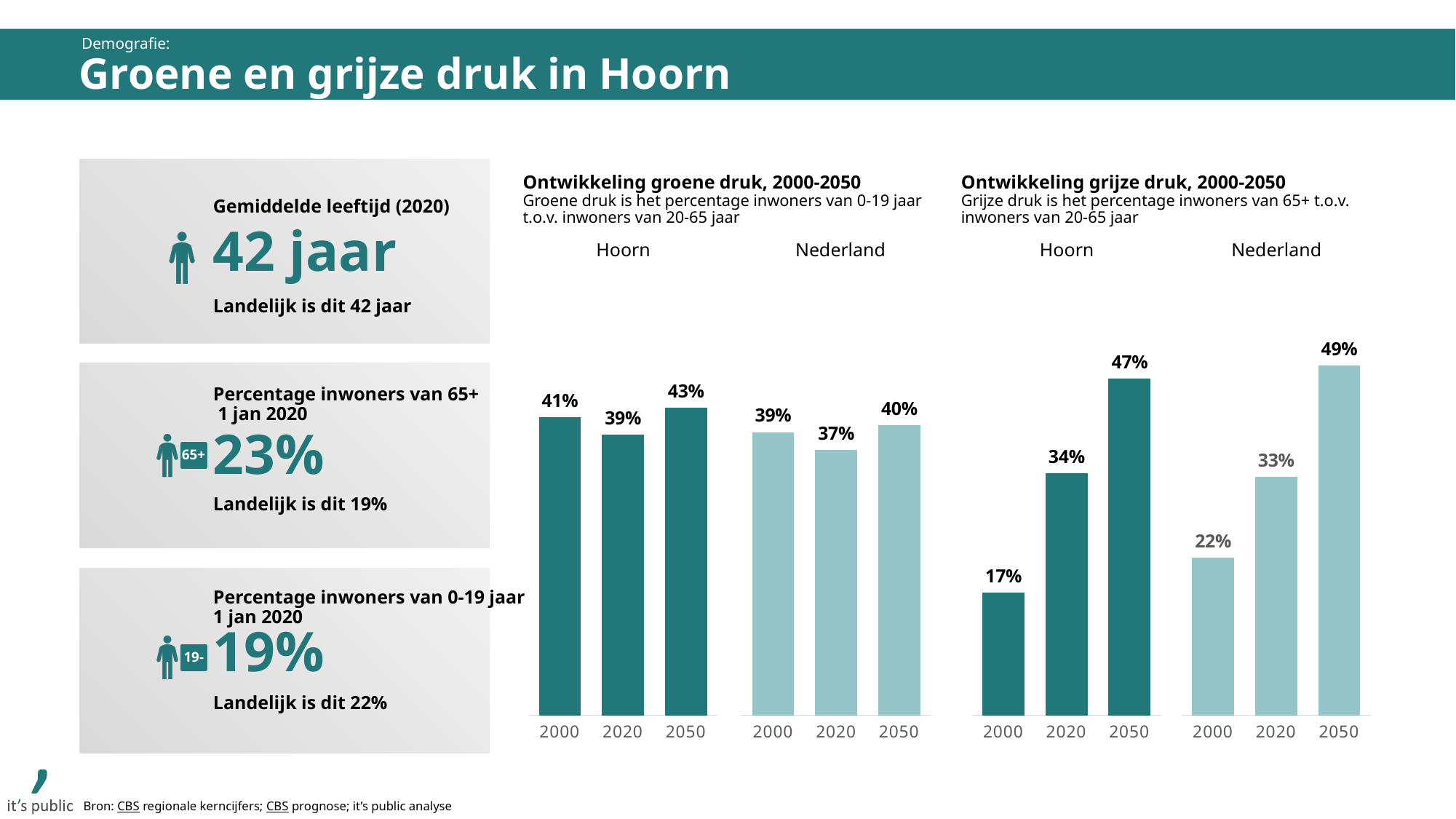
In the 'Ontwikkeling grijze druk, 2000-2050' chart, which bar has the lowest value? Hoorn 2000 How many bars are shown in the 'Ontwikkeling groene druk, 2000-2050' chart? 6 In the 'Ontwikkeling groene druk, 2000-2050' chart, what is the difference between Hoorn and Nederland in 2050? 3% In the 'Ontwikkeling grijze druk, 2000-2050' chart, what is the value for Hoorn in 2050? 47% In the 'Ontwikkeling grijze druk, 2000-2050' chart, which bar has the highest value? Nederland 2050 In the 'Ontwikkeling groene druk, 2000-2050' chart, what is the value for Nederland in 2020? 37% In the 'Ontwikkeling grijze druk, 2000-2050' chart, what is the difference between Hoorn in 2050 and Hoorn in 2000? 30% In the 'Ontwikkeling groene druk, 2000-2050' chart, what is the value for Hoorn in 2000? 41% In the 'Ontwikkeling grijze druk, 2000-2050' chart, do the values for Hoorn rise or fall from 2000 to 2050? rise In the 'Ontwikkeling grijze druk, 2000-2050' chart, which is larger in 2020: Hoorn or Nederland? Hoorn In the 'Ontwikkeling grijze druk, 2000-2050' chart, what is the value for Nederland in 2000? 22% What type of chart is 'Ontwikkeling grijze druk, 2000-2050'? bar chart